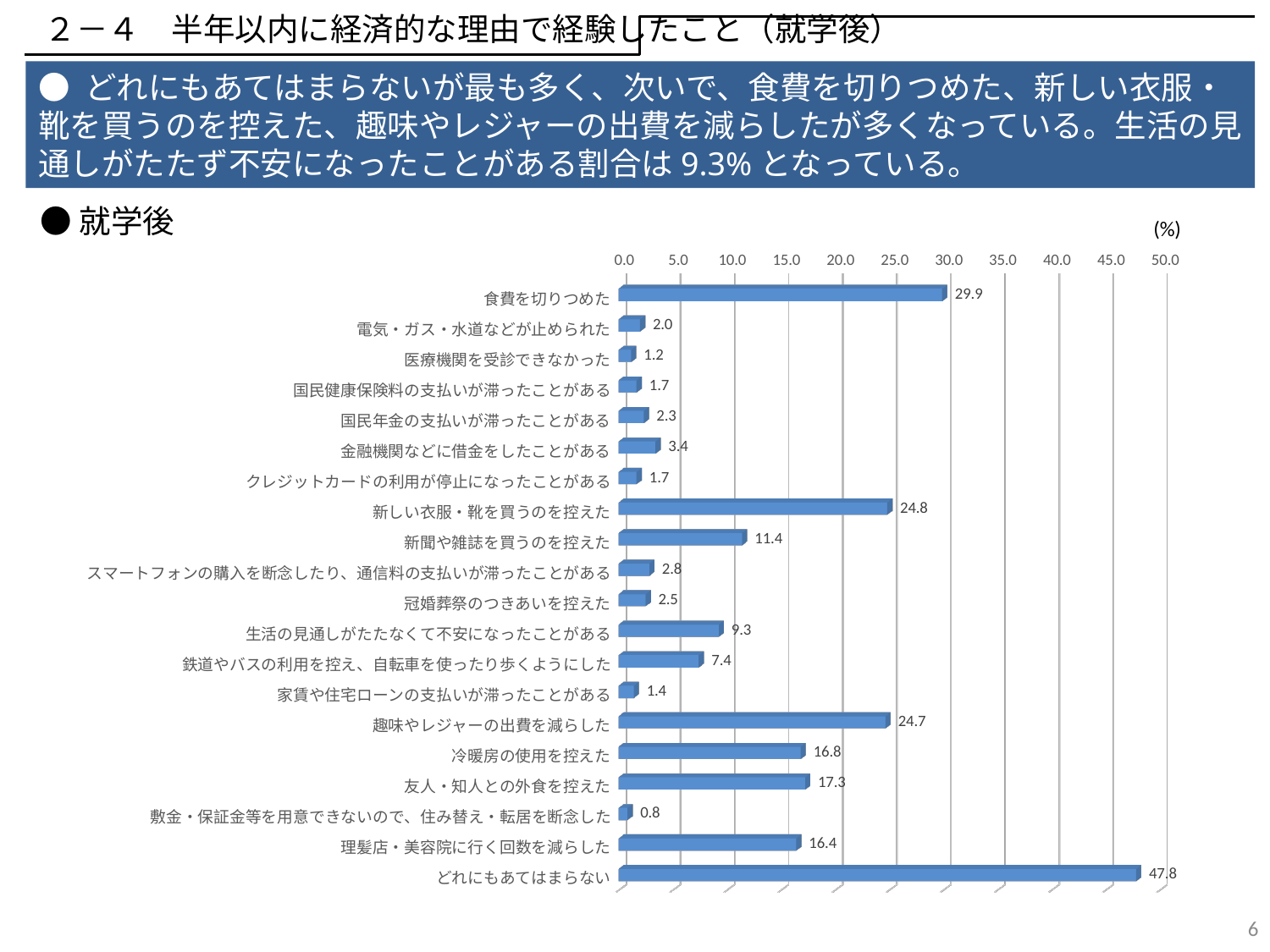
Is the value for どれにもあてはまらない greater or less than 45.0? greater What is the value for 冷暖房の使用を控えた? 16.8 What is the value for 食費を切りつめた? 29.9 What is the value for 生活の見通しがたたなくて不安になったことがある? 9.3 What is the difference between the values for 食費を切りつめた and 新しい衣服・靴を買うのを控えた? 5.1 Which category has the highest value? どれにもあてはまらない Which is larger, the value for 友人・知人との外食を控えた or the value for 理髪店・美容院に行く回数を減らした? 友人・知人との外食を控えた What unit is indicated at the top right of the chart's axis? (%) Which category has the lowest value? 敷金・保証金等を用意できないので、住み替え・転居を断念した How many categories are shown in the chart? 20 What kind of chart is shown on the slide? Bar chart What is the difference between the values for 趣味やレジャーの出費を減らした and 新聞や雑誌を買うのを控えた? 13.3